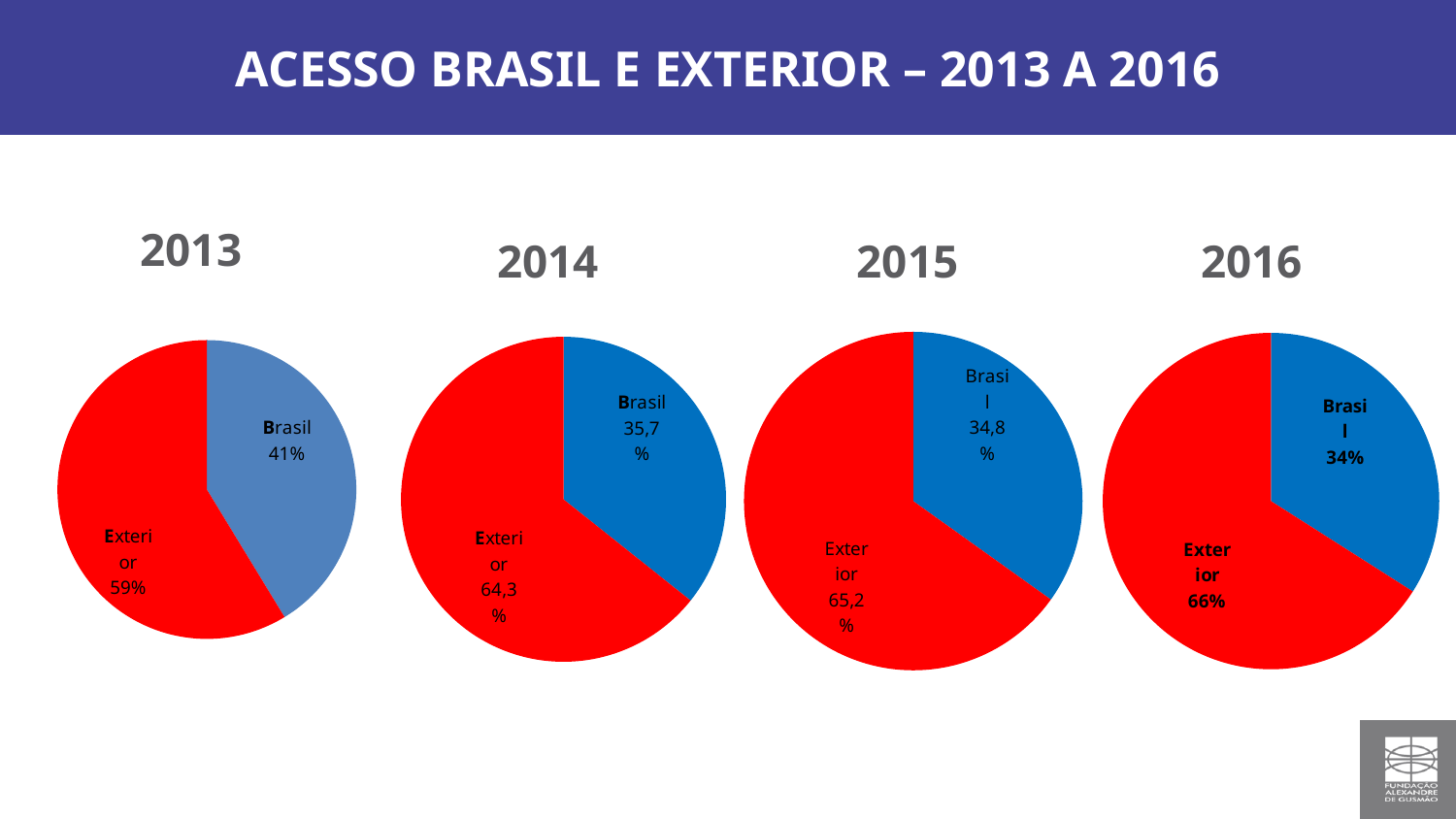
In the 2013 pie chart, what share does Exterior have? 59% In the 2015 pie chart, what is the value for Brasil? 34,8% In the 2014 pie chart, what is the value for Exterior? 64,3% In the 2015 pie chart, what is the value for Exterior? 65,2% In the 2014 pie chart, what is the value for Brasil? 35,7% In the 2013 pie chart, which slice is larger, Brasil or Exterior? Exterior In the 2016 pie chart, what share does Exterior have? 66% In the 2013 pie chart, what is the difference between the Exterior and Brasil shares? 18% What kind of chart is used for each year on the slide? Pie chart How many pie charts are shown on the slide? 4 In the 2016 pie chart, what share does Brasil have? 34% In the 2013 pie chart, what share does Brasil have? 41%